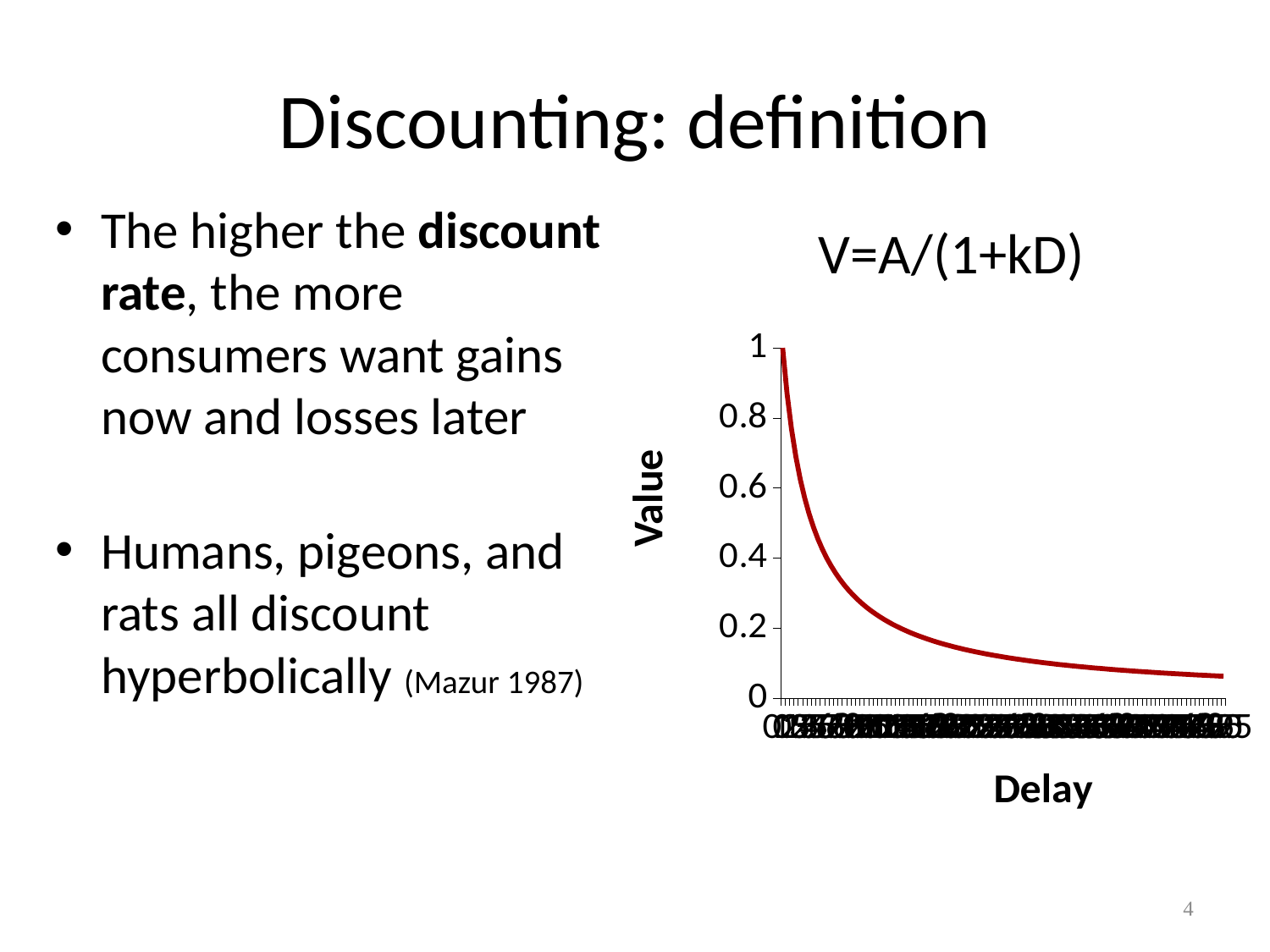
What is the title of the chart's horizontal axis? Delay Is the value at the right-hand end of the curve greater or less than 0.2? less Is the highest value on the curve greater or less than 0.8? greater Do the values on the chart rise or fall as Delay increases along the x axis? fall Is the value at the right-hand end of the curve greater or less than 0.4? less How many lines are plotted on the chart? 1 What is the title of the chart's vertical axis? Value What kind of chart is shown on the slide? line chart